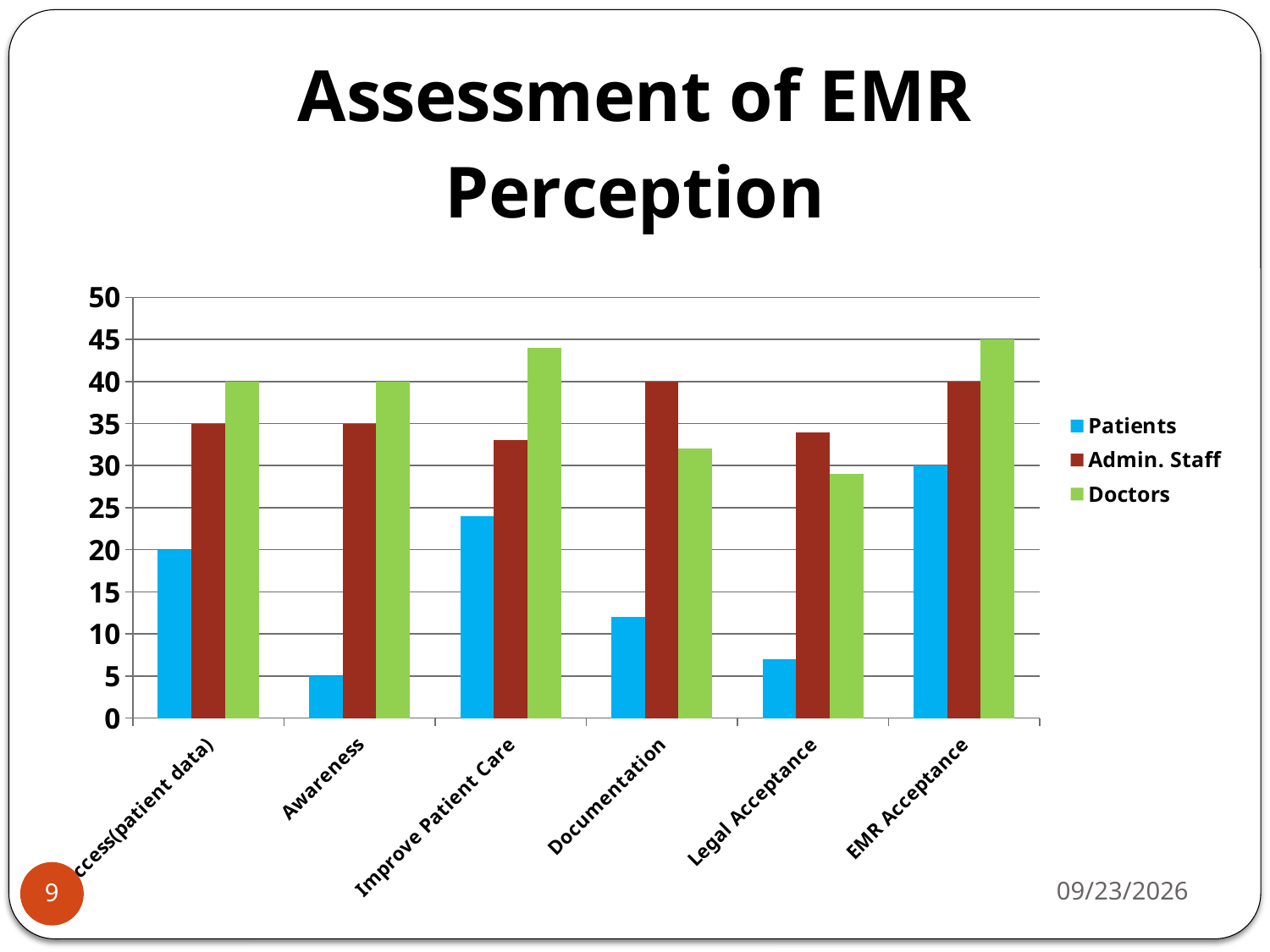
Which category has the highest value for Patients? EMR Acceptance What is the value for Patients in the Awareness category? 5 What is the value for Admin. Staff in the Documentation category? 40 What kind of chart is shown on the slide? bar chart What is the value for Doctors in the Awareness category? 40 What is the value for Patients in the EMR Acceptance category? 30 In the Documentation category, which is larger: Admin. Staff or Doctors? Admin. Staff Which category has the lowest value for Patients? Awareness Is the value for Patients in the Legal Acceptance category greater or less than 10? less How many series does the legend list? 3 Is the value for Doctors in the Improve Patient Care category greater or less than 40? greater How many categories are shown on the x axis? 6